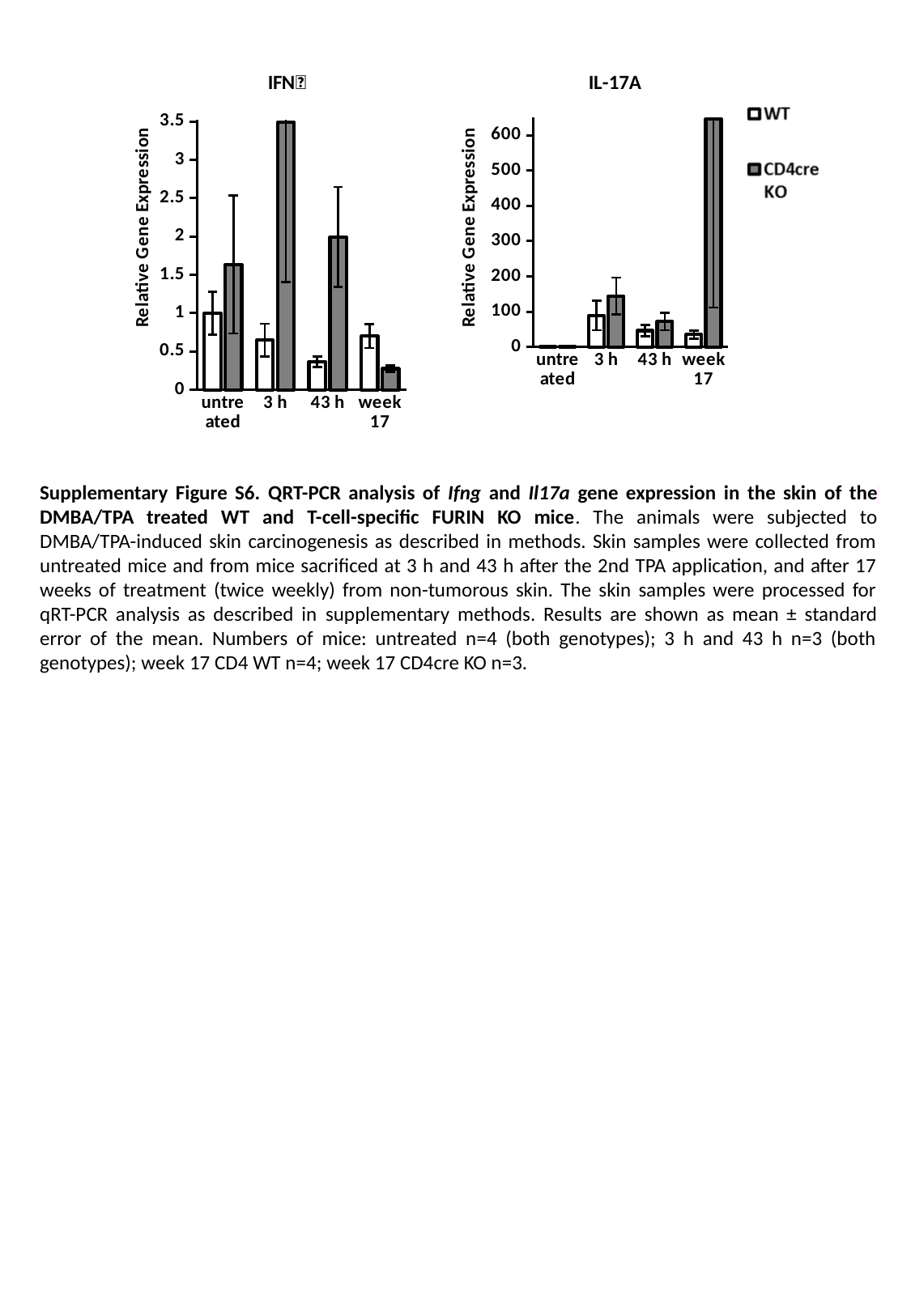
How many categories are shown on the x axis of the IL-17A chart? 4 How many series does the legend list for the charts? 2 In the IFNγ chart, which category has the tallest CD4cre KO bar? 3 h In the IL-17A chart, is the CD4cre KO value at week 17 greater or less than 500? greater In the IFNγ chart, is the CD4cre KO value at 3 h greater or less than 3? greater In the IL-17A chart, which is larger at 43 h, the WT bar or the CD4cre KO bar? CD4cre KO In the IFNγ chart, which is larger at week 17, the WT bar or the CD4cre KO bar? WT In the IFNγ chart, which category has the lowest WT bar? 43 h What kind of chart is the IFNγ chart on the left? bar chart In the IL-17A chart, which category has the tallest CD4cre KO bar? week 17 In the IL-17A chart, is the WT value at 3 h greater or less than 50? greater What is the y-axis label on the IL-17A chart? Relative Gene Expression